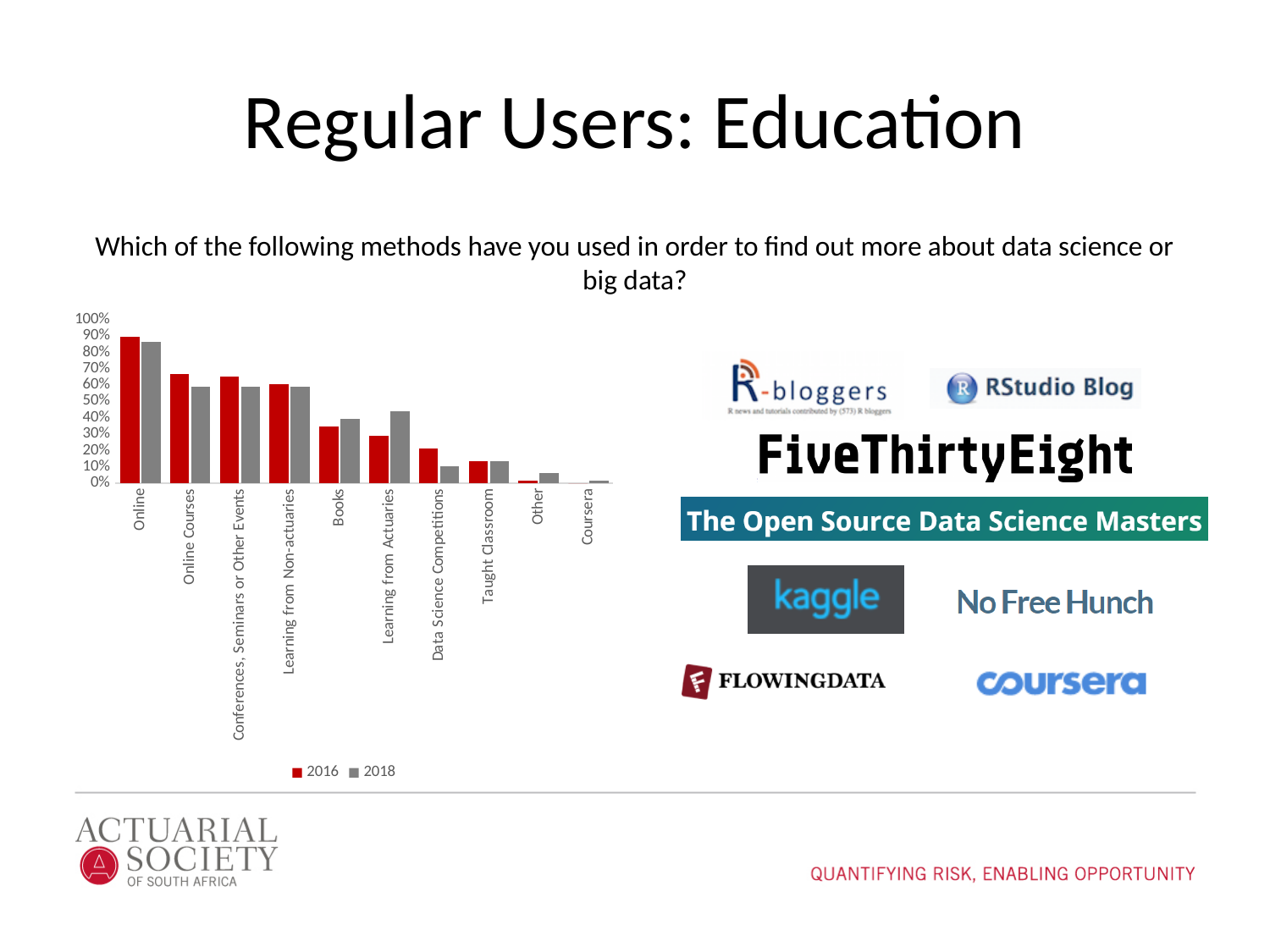
Which category has the highest value for the 2016 series? Online For Learning from Actuaries, which series has the larger value, 2016 or 2018? 2018 Is the 2018 value for Data Science Competitions greater or less than 20%? less For Data Science Competitions, which series has the larger value, 2016 or 2018? 2016 Which colour represents the 2016 series in the chart? Red How many series does the chart's legend list? 2 Do the 2016 values generally rise or fall moving from left to right along the x axis? fall What kind of chart is shown on the slide? Bar chart How many categories are shown on the x axis of the chart? 10 Which category has the lowest value for the 2018 series? Coursera Is the 2016 value for Online Courses greater or less than 60%? greater Is the 2016 value for Online greater or less than 80%? greater